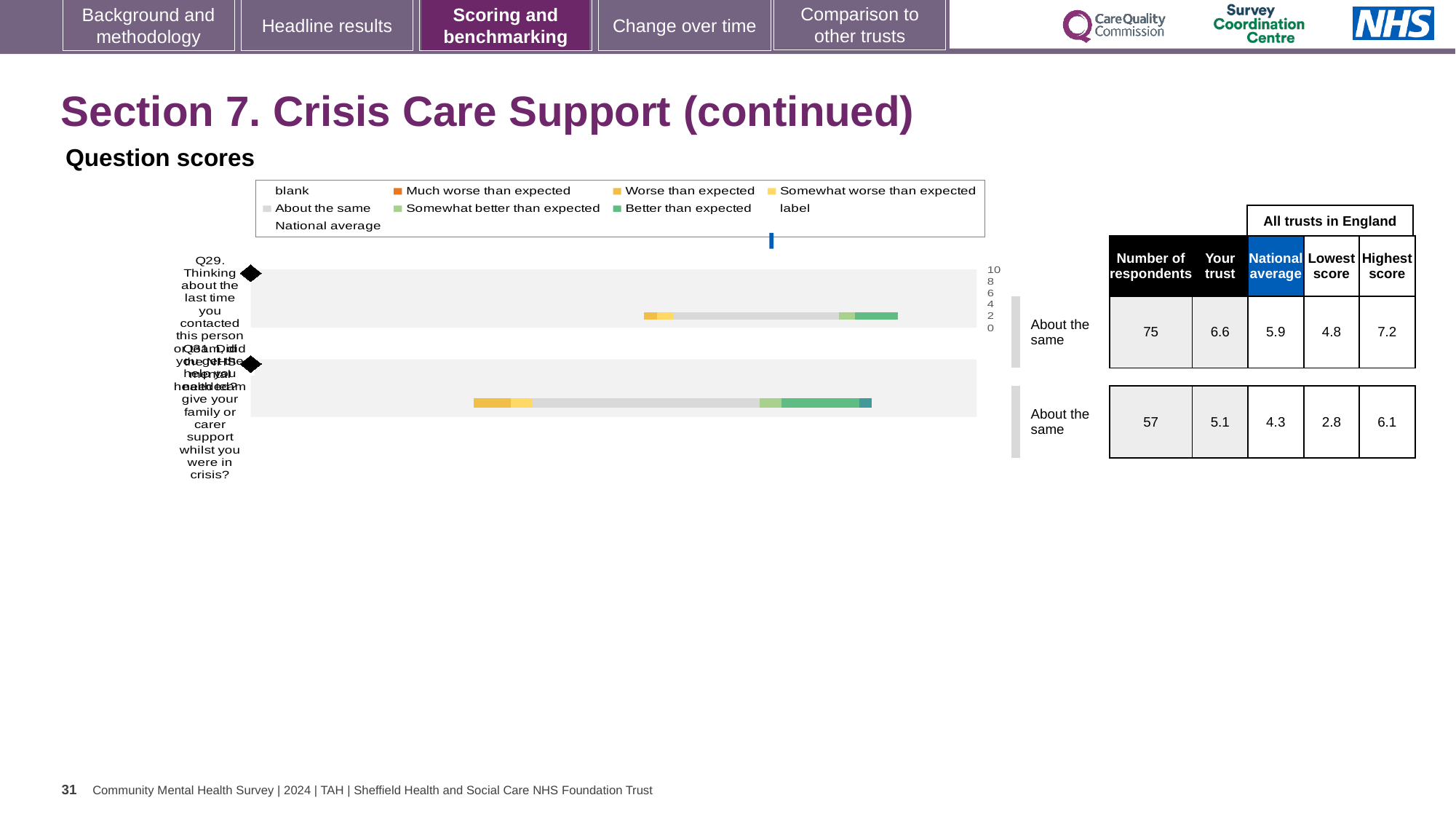
Which question has more respondents, Q29 or Q31? Q29 What is the national average score for Q31? 4.3 What is the difference between the 'Your trust' score and the national average for Q29? 0.7 What is the number of respondents for Q29? 75 What is the lowest score among all trusts in England for Q31? 2.8 What kind of chart is shown under 'Question scores'? bar chart In the chart legend, what colour represents 'Much worse than expected'? orange How many questions (bars) are plotted in the Question scores chart? 2 What is the 'Your trust' score for Q29 in the table beside the chart? 6.6 In the chart legend, what colour represents 'Better than expected'? green Which question has the higher 'Your trust' score, Q29 or Q31? Q29 What is the highest score among all trusts in England for Q29? 7.2